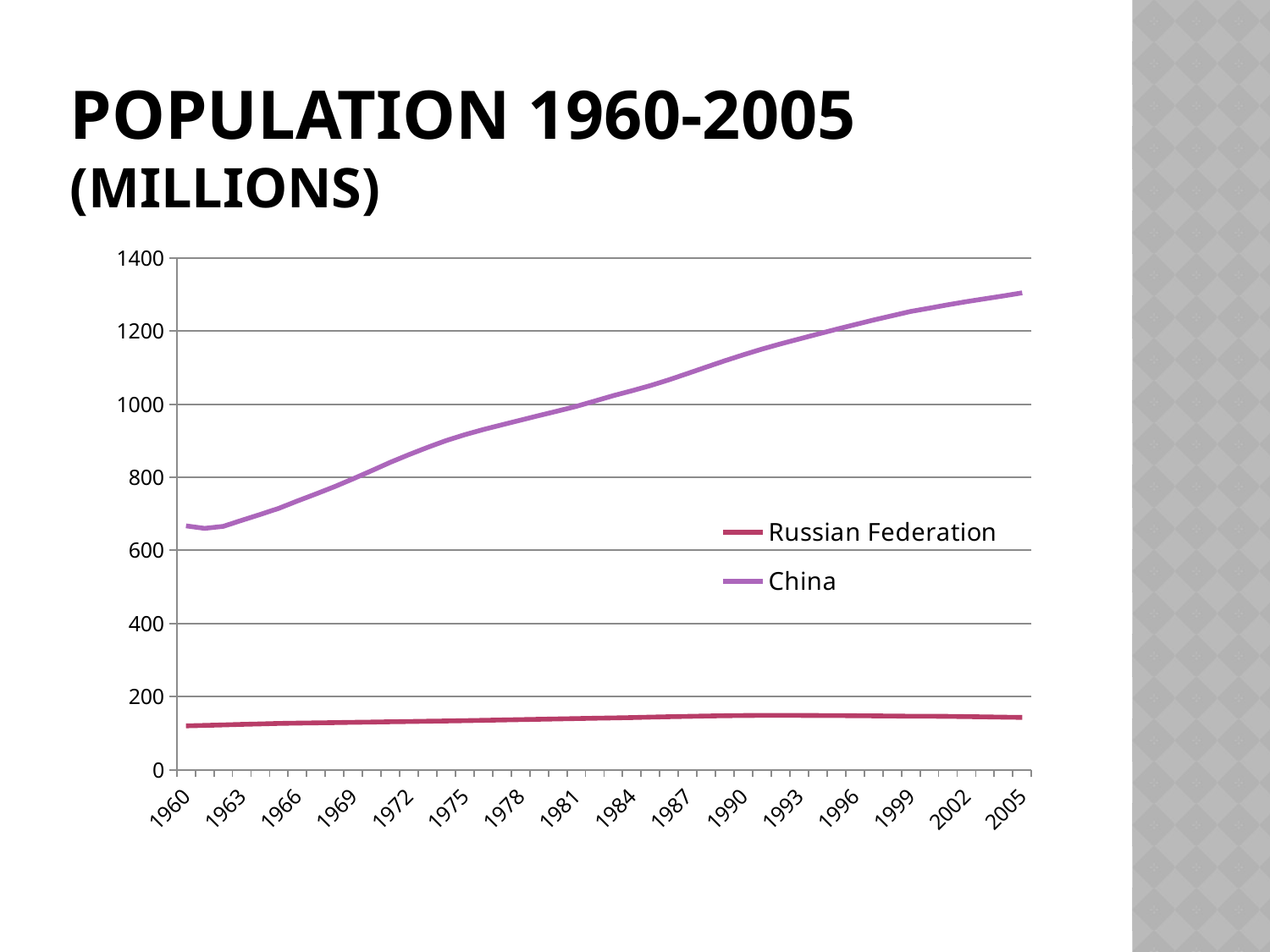
What kind of chart is shown on the slide? line chart Is the population of China in 1960 greater or less than 600? greater Is the population of China in 1990 greater or less than 1000? greater Does the population of China rise or fall from 1960 to 2005? rise What is the title of the chart on the slide? Population 1960-2005 (millions) Is the population of the Russian Federation in 2005 greater or less than 200? less What are the two series named in the legend? Russian Federation and China In which year shown on the x axis does China reach its highest population? 2005 How many series does the legend list? 2 Which series has the lower population throughout the chart? Russian Federation Which series has the higher population in 2005, China or Russian Federation? China